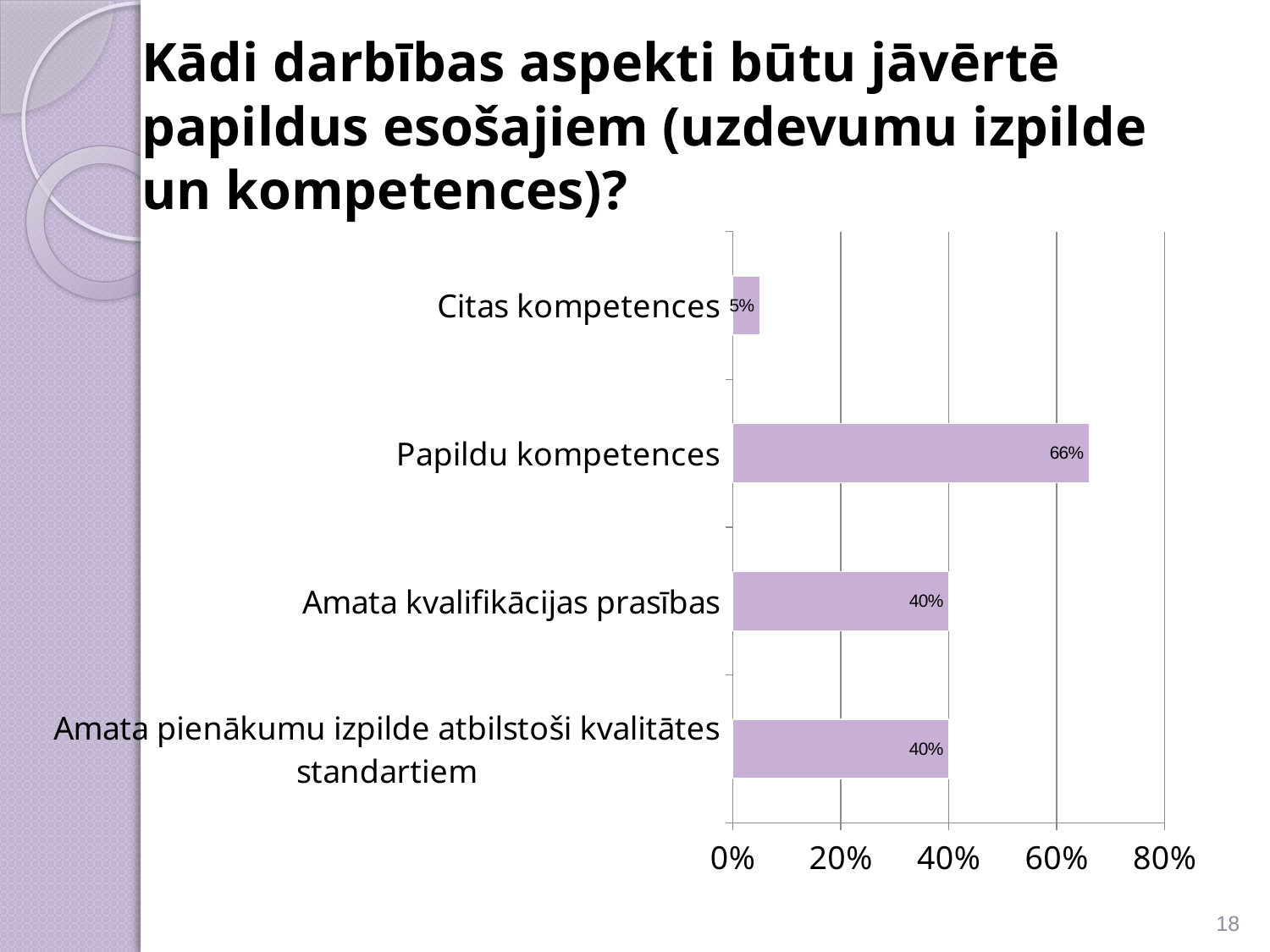
What kind of chart is shown on the slide? bar chart Which category has the lowest value? Citas kompetences What is the value for Amata kvalifikācijas prasības? 40% Which is larger, the value for Papildu kompetences or the value for Citas kompetences? Papildu kompetences Is the value for Papildu kompetences greater or less than 60%? greater What is the value for Papildu kompetences? 66% What is the value for Amata pienākumu izpilde atbilstoši kvalitātes standartiem? 40% What is the difference between the values for Papildu kompetences and Citas kompetences? 61% What is the value for Citas kompetences? 5% How many categories are shown in the chart? 4 What is the difference between the values for Papildu kompetences and Amata kvalifikācijas prasības? 26% Which category has the highest value? Papildu kompetences